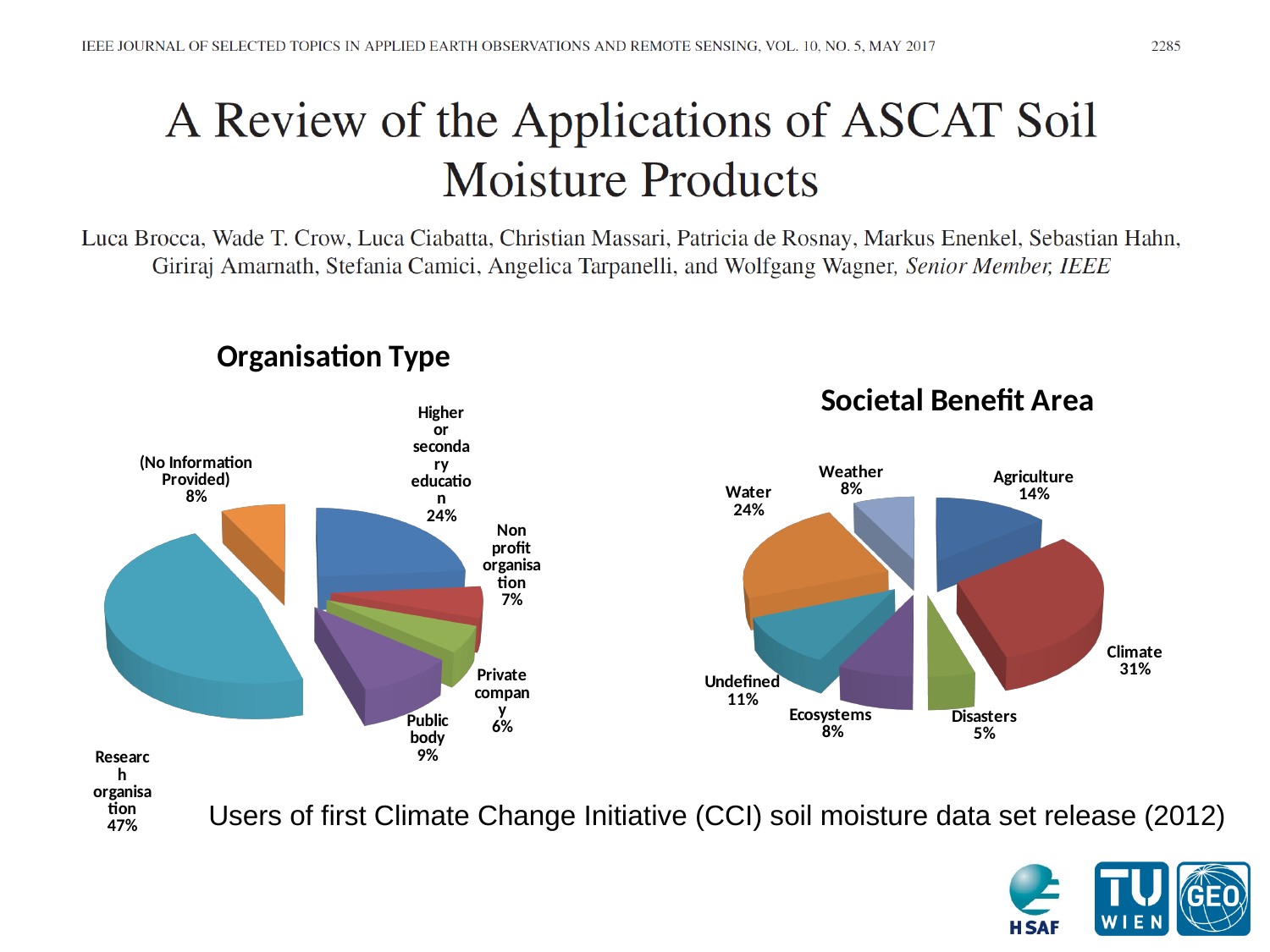
In the "Societal Benefit Area" chart, what share is labelled for Water? 24% In the "Societal Benefit Area" chart, what share is labelled for Climate? 31% In the "Organisation Type" chart, what share is labelled for Research organisation? 47% In the "Organisation Type" chart, which category has the largest slice? Research organisation What kind of chart is the "Societal Benefit Area" chart? Pie chart In the "Societal Benefit Area" chart, which category has the smallest slice? Disasters In the "Organisation Type" chart, which category has the smallest slice? Private company In the "Societal Benefit Area" chart, how many categories are shown? 7 In the "Organisation Type" chart, what is the difference between the Public body share and the Non profit organisation share? 2% In the "Societal Benefit Area" chart, which is larger, Agriculture or Undefined? Agriculture In the "Organisation Type" chart, what share is labelled for Higher or secondary education? 24% In the "Organisation Type" chart, how many categories are shown? 6